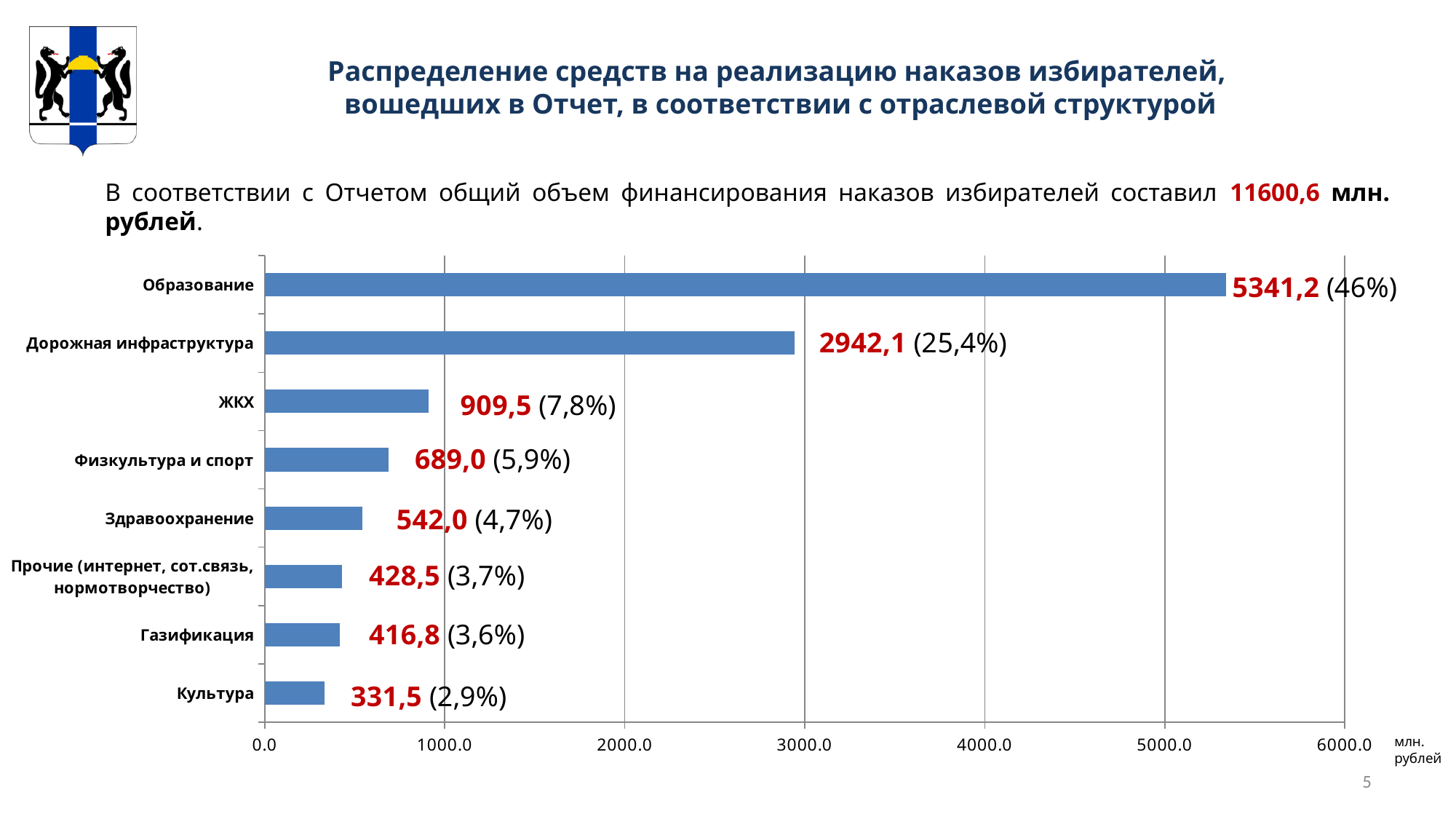
What is the value for Культура? 331,5 What is the difference between the values for ЖКХ and Физкультура и спорт? 220,5 What is the value for Образование? 5341,2 What is the value for Дорожная инфраструктура? 2942,1 Is the value for ЖКХ greater or less than 1000.0? less Which category has the highest value? Образование Which category has the lowest value? Культура What percentage share is shown for ЖКХ? 7,8% Which is larger, the value for Газификация or the value for Культура? Газификация What is the difference between the values for Образование and Дорожная инфраструктура? 2399,1 How many categories are shown in the chart? 8 What kind of chart is shown on the slide? bar chart